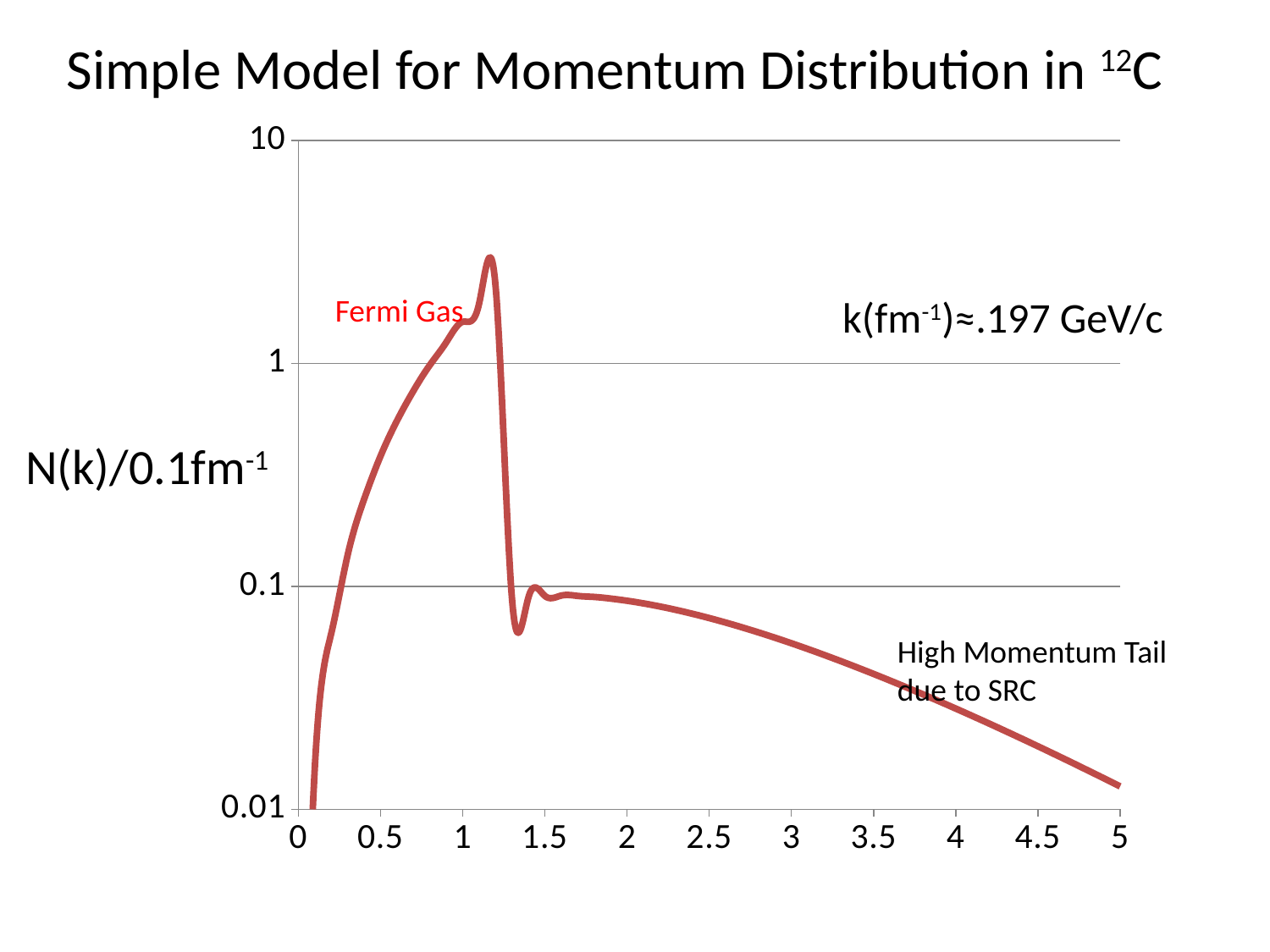
Is the value of the curve at k = 5 greater or less than 0.1? less Is the value of the curve at k = 3 greater or less than 0.1? less Do the values of the curve rise or fall as k increases from 0 to 1? rise What is the title of the chart on the slide? Simple Model for Momentum Distribution in 12C Which is larger, the value of the curve at k = 2 or at k = 4? k = 2 Is the peak value of the curve greater or less than 10? less What label is written in red near the rising part of the curve? Fermi Gas Do the values of the curve rise or fall as k increases from 2 to 5? fall What kind of chart is shown on the slide? line chart Which is larger, the value of the curve at k = 1 or at k = 3? k = 1